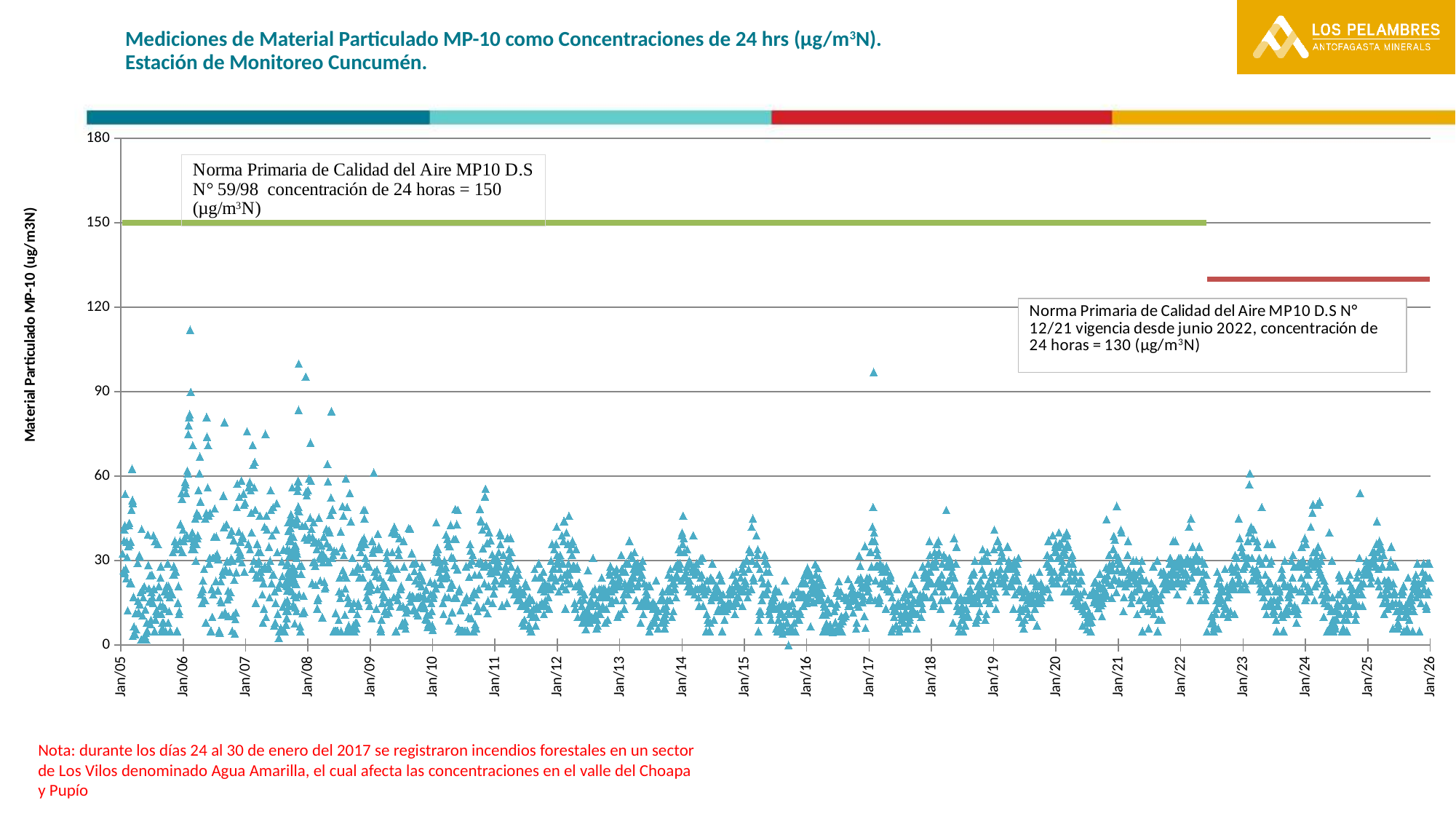
What is the label of the y-axis of the chart? Material Particulado MP-10 (ug/m3N) What kind of chart is shown on the slide? Scatter chart Is the highest measured MP-10 value on the chart greater or less than 90? greater What is the 24-hour concentration limit set by Norma Primaria de Calidad del Aire MP10 D.S N° 59/98, as shown on the chart? 150 (µg/m³N) Which standard line on the chart is higher, the green D.S N° 59/98 line or the red D.S N° 12/21 line? The green D.S N° 59/98 line What is the difference between the D.S N° 59/98 limit (150) and the D.S N° 12/21 limit (130) shown on the chart? 20 Is the highest measured MP-10 value on the chart greater or less than 150? less Do the measured MP-10 values in the early years (2005–2008) tend to be higher or lower than in the later years of the chart? Higher What is the highest value shown on the y-axis of the chart? 180 What are the first and last labels on the x-axis of the chart? Jan/05 and Jan/26 How many year labels are shown on the x-axis of the chart? 22 What is the 24-hour concentration limit set by Norma Primaria de Calidad del Aire MP10 D.S N° 12/21, as shown on the chart? 130 (µg/m³N)